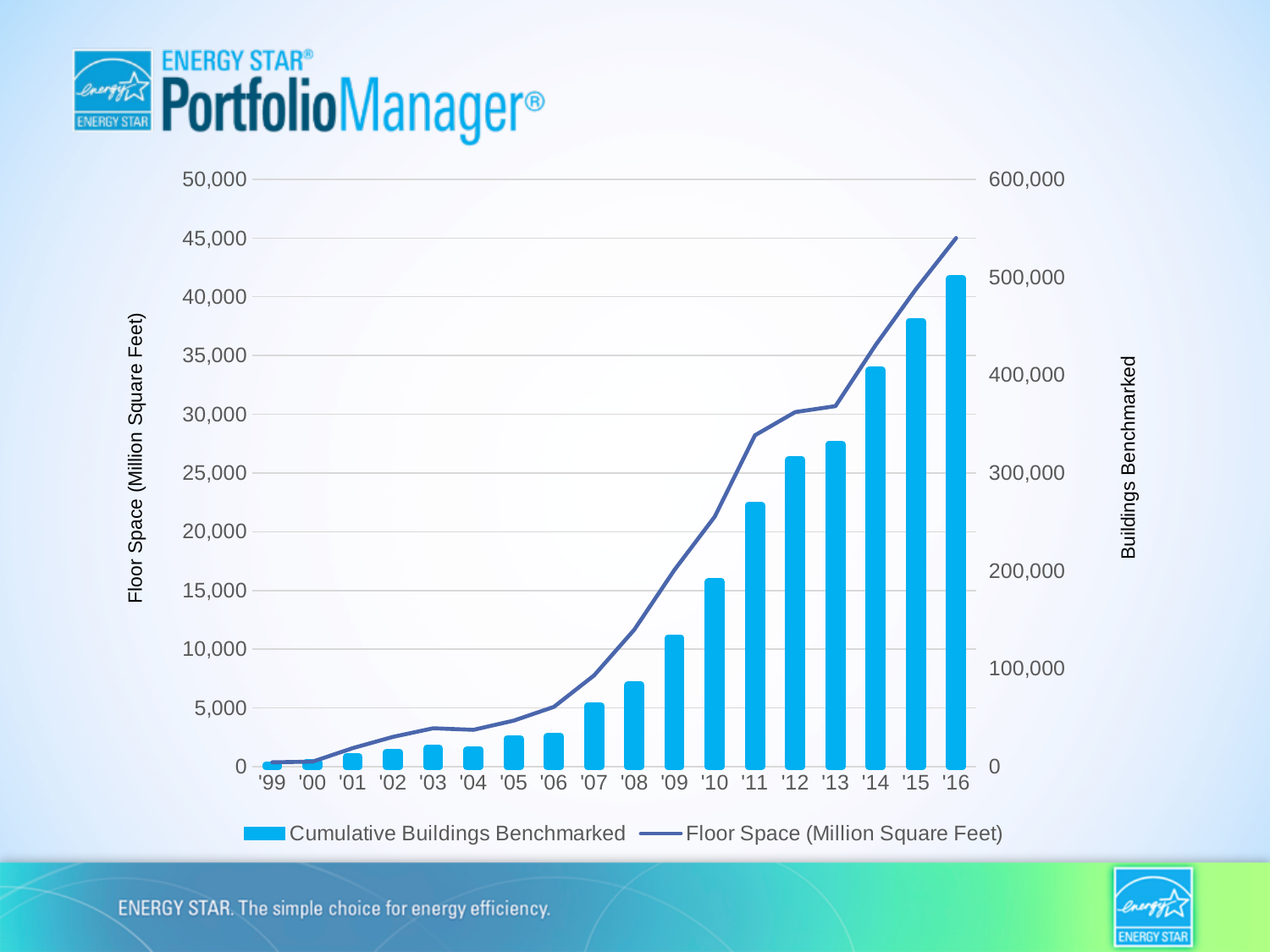
What kind of chart is shown on the slide? A combined bar and line chart How many series does the legend list? 2 Is the Cumulative Buildings Benchmarked value for '08 greater or less than 100,000? less Which year has the lowest value for Cumulative Buildings Benchmarked? '99 Is the Cumulative Buildings Benchmarked value for '11 greater or less than 300,000? less Is the Floor Space (Million Square Feet) value for '16 greater or less than 40,000? greater How many years are shown along the x axis? 18 What is the label of the right-hand vertical axis? Buildings Benchmarked Which year has the highest value for Cumulative Buildings Benchmarked? '16 Which is larger, the Cumulative Buildings Benchmarked value for '12 or for '14? '14 Do the Floor Space (Million Square Feet) values rise or fall from '99 to '16? Rise